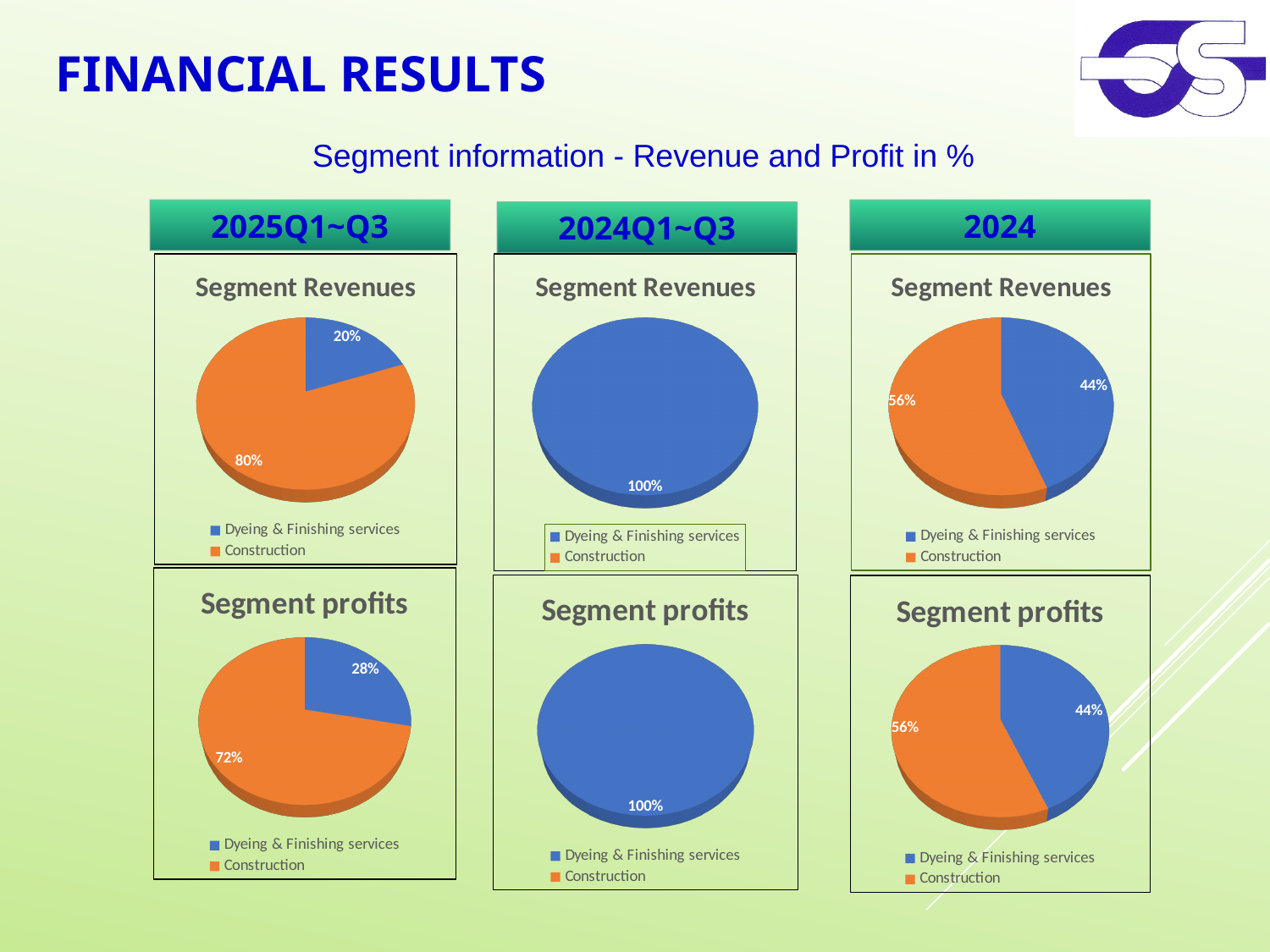
In the 2024 Segment profits pie chart, what share does Dyeing & Finishing services have? 44% How many entries does the legend of the 2025Q1~Q3 Segment Revenues chart list? 2 In the 2024 Segment Revenues pie chart, which segment has the smaller share? Dyeing & Finishing services What type of chart is used for the 2024 Segment profits chart? Pie chart In the 2025Q1~Q3 Segment profits pie chart, what share does Dyeing & Finishing services have? 28% In the 2024 Segment Revenues pie chart, what share does Construction have? 56% In the 2025Q1~Q3 Segment Revenues pie chart, what is the difference between the Construction share and the Dyeing & Finishing services share? 60% In the 2025Q1~Q3 Segment profits pie chart, which segment has the larger share? Construction